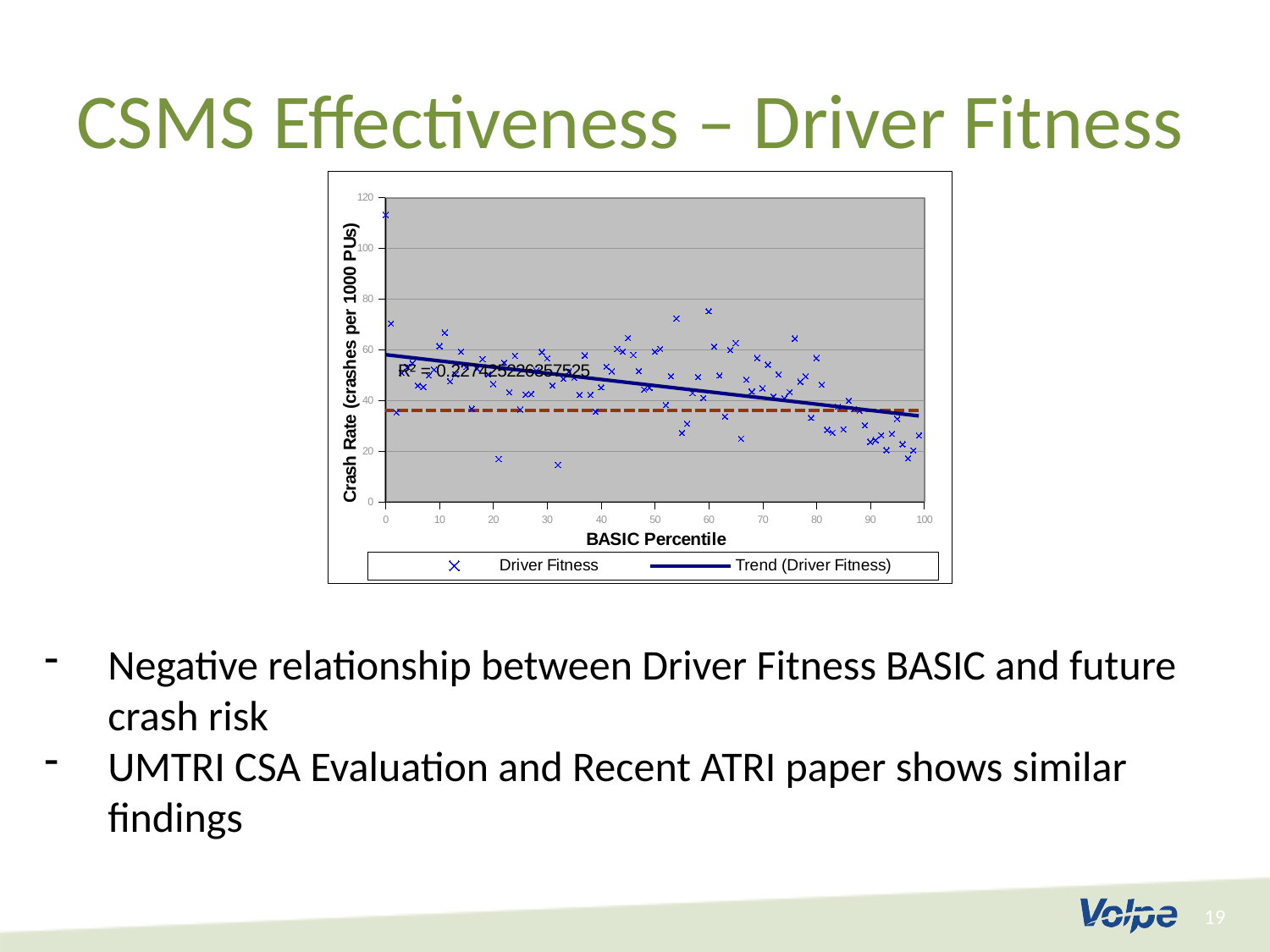
How many series does the chart legend list? 2 What is the title of the y axis of the chart? Crash Rate (crashes per 1000 PUs) What is the title of the x axis of the chart? BASIC Percentile Is the trend line value at BASIC Percentile 0 larger or smaller than its value at BASIC Percentile 100? larger What is the highest value shown on the y axis of the chart? 120 What kind of chart is shown on the slide? scatter chart Is the crash rate of the lowest Driver Fitness data point greater or less than 20? less Is the value of the trend line at BASIC Percentile 100 greater or less than 40? less What is the highest value shown on the x axis of the chart? 100 Is the crash rate of the highest Driver Fitness data point greater or less than 100? greater Does the trend line for Driver Fitness rise or fall as BASIC Percentile increases? fall